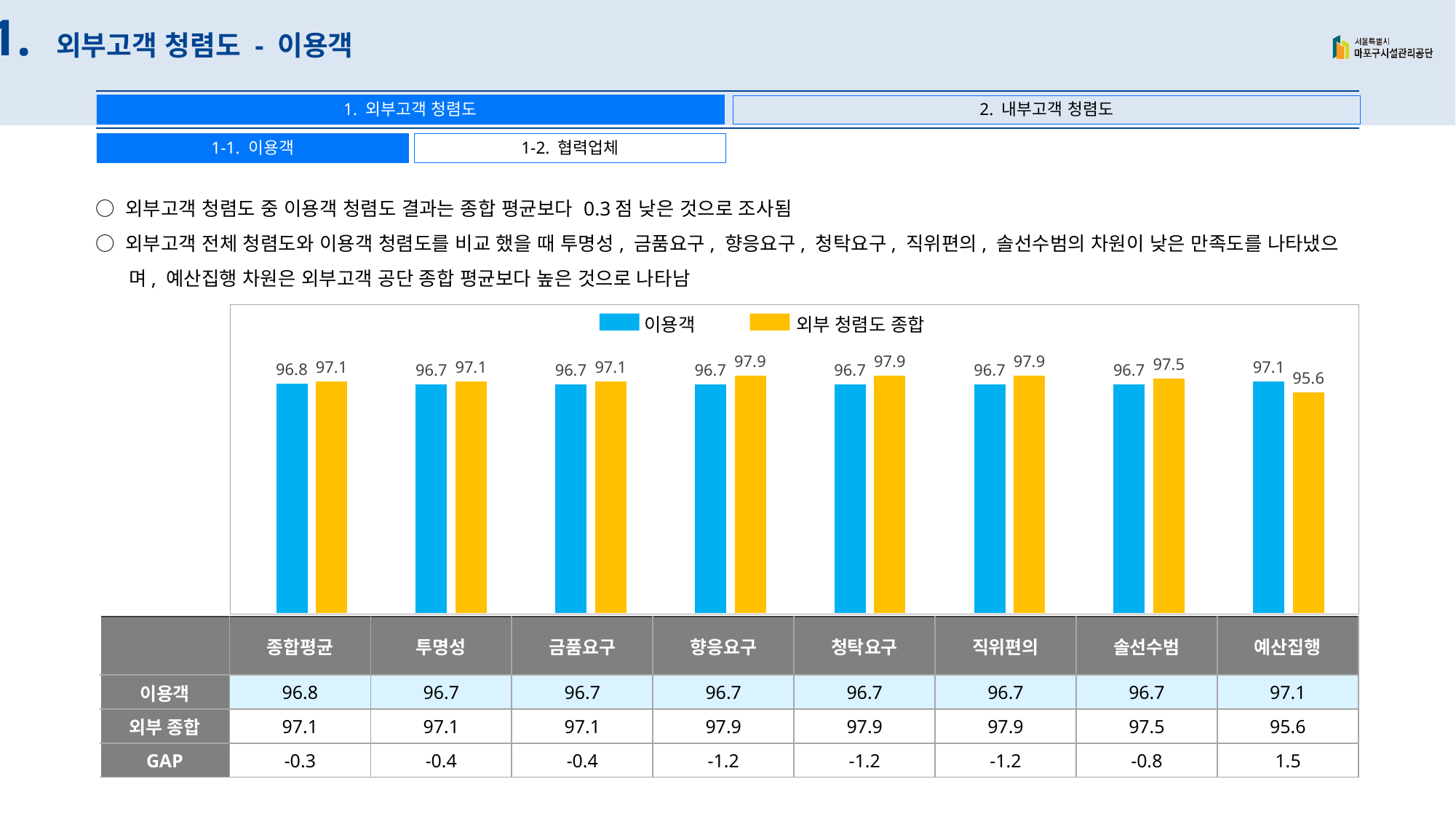
Which series is shown in yellow in the chart? 외부 청렴도 종합 For 예산집행, which is larger: the 이용객 value or the 외부 청렴도 종합 value? 이용객 How many categories are shown along the x axis of the chart? 8 What is the 외부 청렴도 종합 value for 솔선수범? 97.5 What kind of chart is shown on the slide? bar chart What is the 이용객 value for 예산집행? 97.1 What is the 이용객 value for 종합평균? 96.8 What is the difference between the 외부 청렴도 종합 and 이용객 values for 청탁요구? 1.2 What is the 외부 청렴도 종합 value for 향응요구? 97.9 Which category has the highest 이용객 value? 예산집행 How many series does the chart legend list? 2 Which category has the lowest 외부 청렴도 종합 value? 예산집행